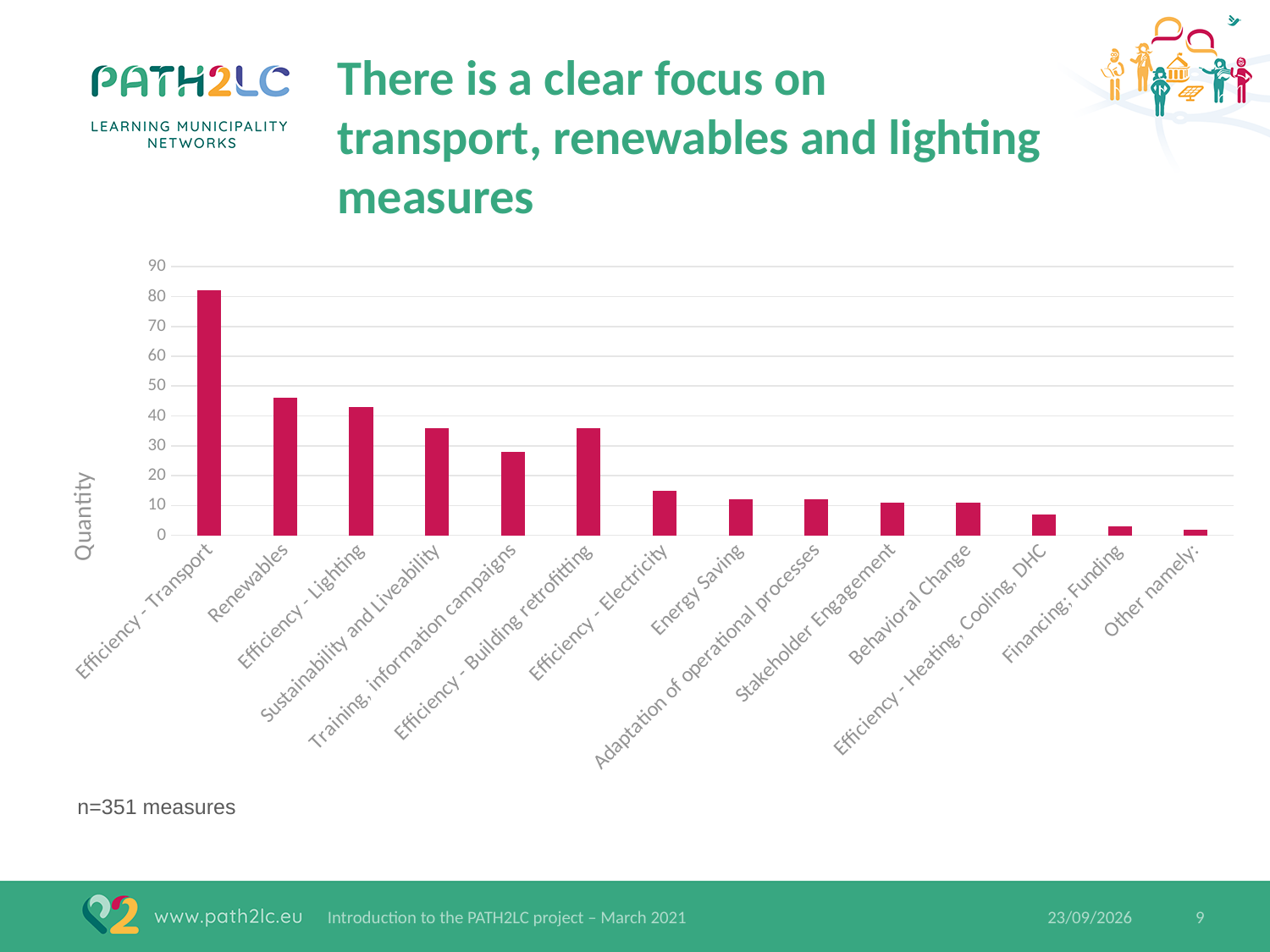
Which category has the highest value? Efficiency - Transport How many categories are plotted on the x axis? 14 Which is larger, the value for Training, information campaigns or the value for Efficiency - Building retrofitting? Efficiency - Building retrofitting Is the value for Efficiency - Electricity greater or less than 20? less Is the value for Sustainability and Liveability greater or less than 40? less What is the label on the y axis? Quantity What kind of chart is shown on the slide? bar chart Is the value for Financing; Funding greater or less than 10? less Do the values generally rise or fall from left to right along the x axis? fall Which category has the lowest value? Other namely: